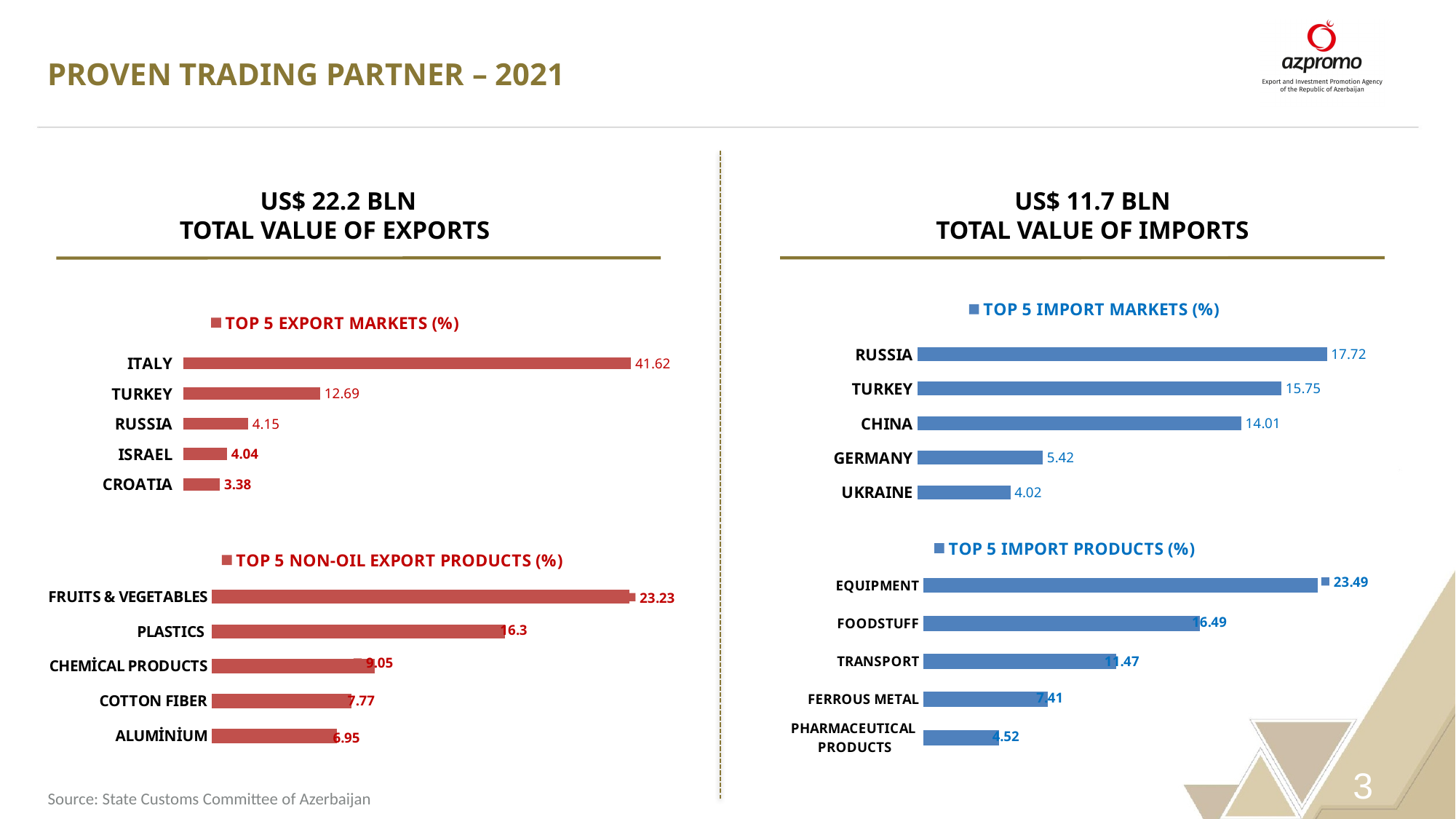
In the 'TOP 5 IMPORT MARKETS (%)' chart, which is larger, Germany or Ukraine? Germany In the 'TOP 5 IMPORT MARKETS (%)' chart, which country has the highest value? Russia What kind of chart is the 'TOP 5 IMPORT PRODUCTS (%)' chart? Bar chart In the 'TOP 5 NON-OIL EXPORT PRODUCTS (%)' chart, what is the value for Plastics? 16.3 In the 'TOP 5 EXPORT MARKETS (%)' chart, what is the value for Italy? 41.62 In the 'TOP 5 NON-OIL EXPORT PRODUCTS (%)' chart, how many categories are shown? 5 In the 'TOP 5 IMPORT PRODUCTS (%)' chart, what is the difference between Equipment and Foodstuff? 7.00 In the 'TOP 5 EXPORT MARKETS (%)' chart, which country has the lowest value? Croatia In the 'TOP 5 IMPORT MARKETS (%)' chart, what is the value for China? 14.01 In the 'TOP 5 EXPORT MARKETS (%)' chart, what is the difference between Italy and Turkey? 28.93 In the 'TOP 5 IMPORT PRODUCTS (%)' chart, what is the value for Ferrous Metal? 7.41 How many charts are shown on the slide? 4